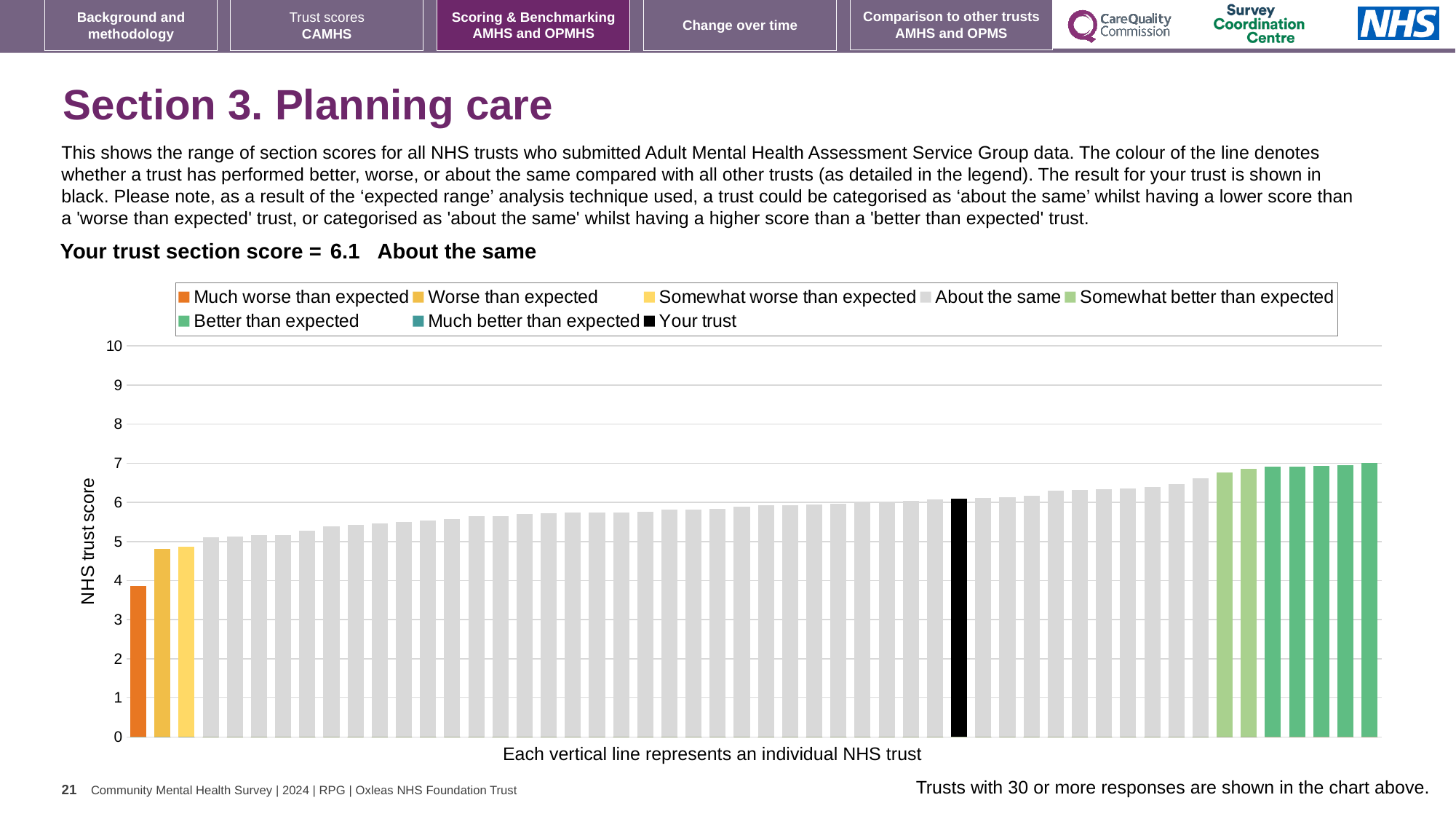
What is the label on the vertical axis of the chart? NHS trust score Do the bar values rise or fall from left to right along the x axis? rise How many bars are coloured as 'Much worse than expected'? 1 What is the section score for your trust? 6.1 Which legend category does the tallest bar in the chart belong to? Better than expected Is the value for the tallest bar greater or less than 8? less Is the value for the shortest bar (Much worse than expected) greater or less than 5? less How many bars are coloured as 'Better than expected'? 5 How many entries does the chart legend list? 8 Which legend category does the shortest bar in the chart belong to? Much worse than expected Is the value for the tallest bar greater or less than 6? greater What kind of chart is shown on the slide? bar chart